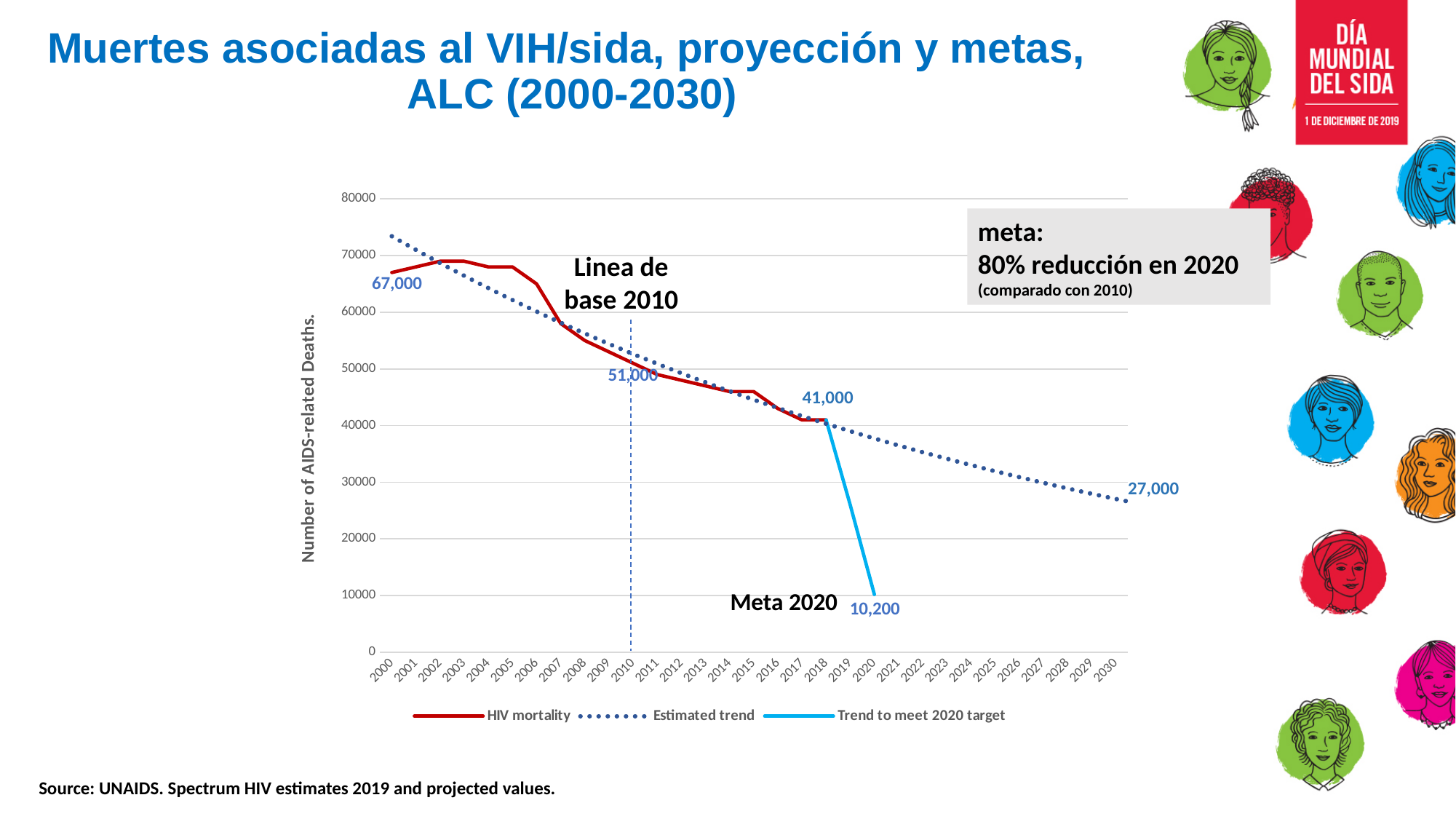
What is the labelled value of HIV mortality in 2010, the baseline year? 51,000 Does HIV mortality rise or fall from 2000 to 2018 overall? Fall What is the labelled value of the estimated trend in 2030? 27,000 What is the difference between the estimated trend value for 2030 and the 2020 target value? 16,800 Is the HIV mortality value for 2005 greater or less than 60000? greater Which series is drawn as a dotted line in the chart? Estimated trend By how much did HIV mortality fall between 2000 and 2018, according to the labelled values? 26,000 How many series does the chart legend list? 3 What is the labelled value of the 2020 target (Meta 2020)? 10,200 What is the labelled value of HIV mortality in 2018? 41,000 What kind of chart is shown on the slide? Line chart What is the labelled value of HIV mortality in 2000? 67,000